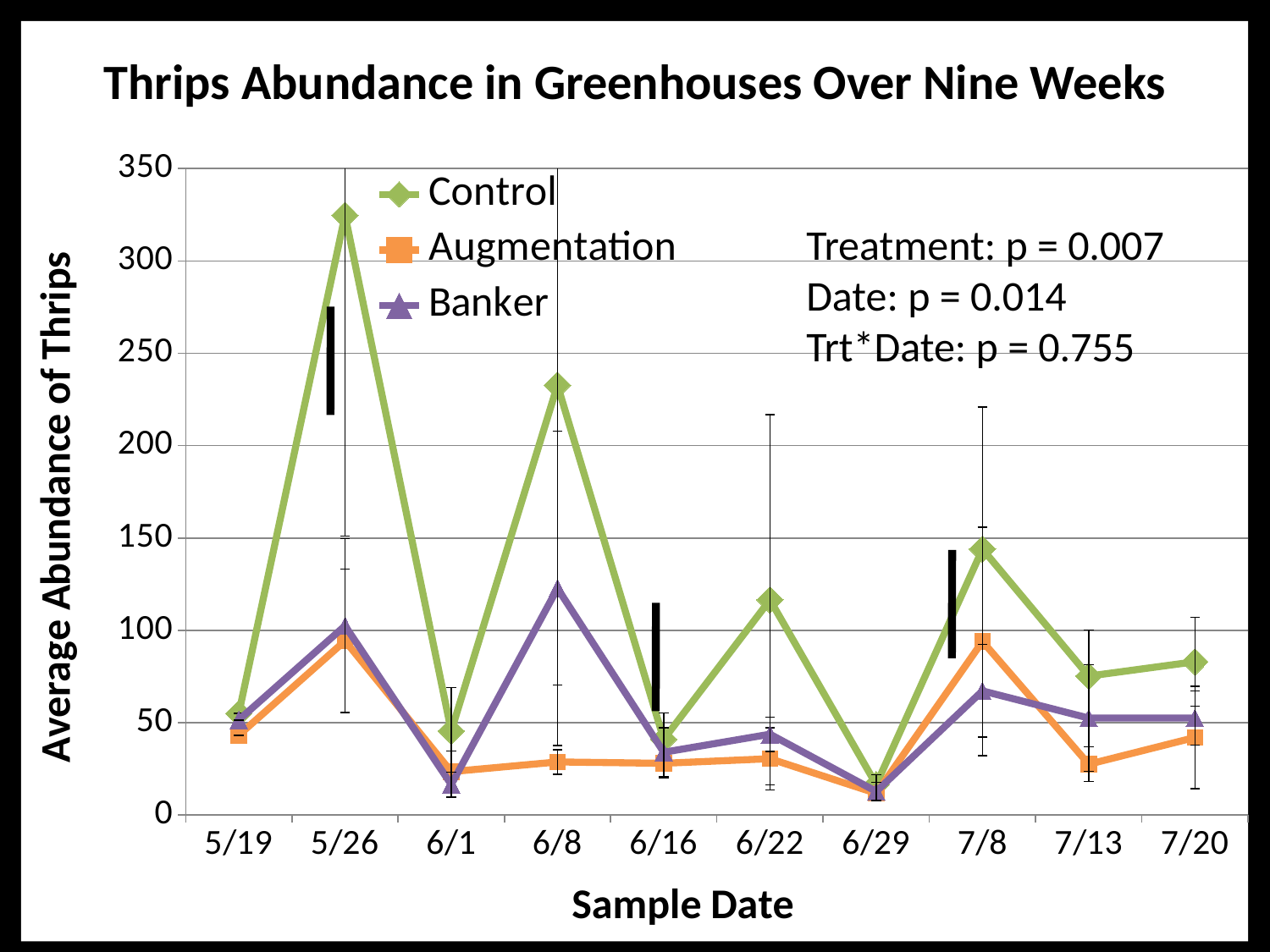
How many sample dates are shown on the x axis? 10 On which sample date does the Control series reach its lowest value? 6/29 On which sample date does the Control series reach its highest value? 5/26 How many series does the legend list? 3 Is the Augmentation value on 6/1 greater or less than 50? less Which series has the larger value on 6/8, Banker or Augmentation? Banker What is the title of the chart? Thrips Abundance in Greenhouses Over Nine Weeks Does the Control series rise or fall from 7/8 to 7/13? fall What p-value is given for Treatment on the slide? 0.007 Is the Control value on 5/26 greater or less than 300? greater What kind of chart is shown on the slide? line chart Is the Control value on 6/8 greater or less than 200? greater